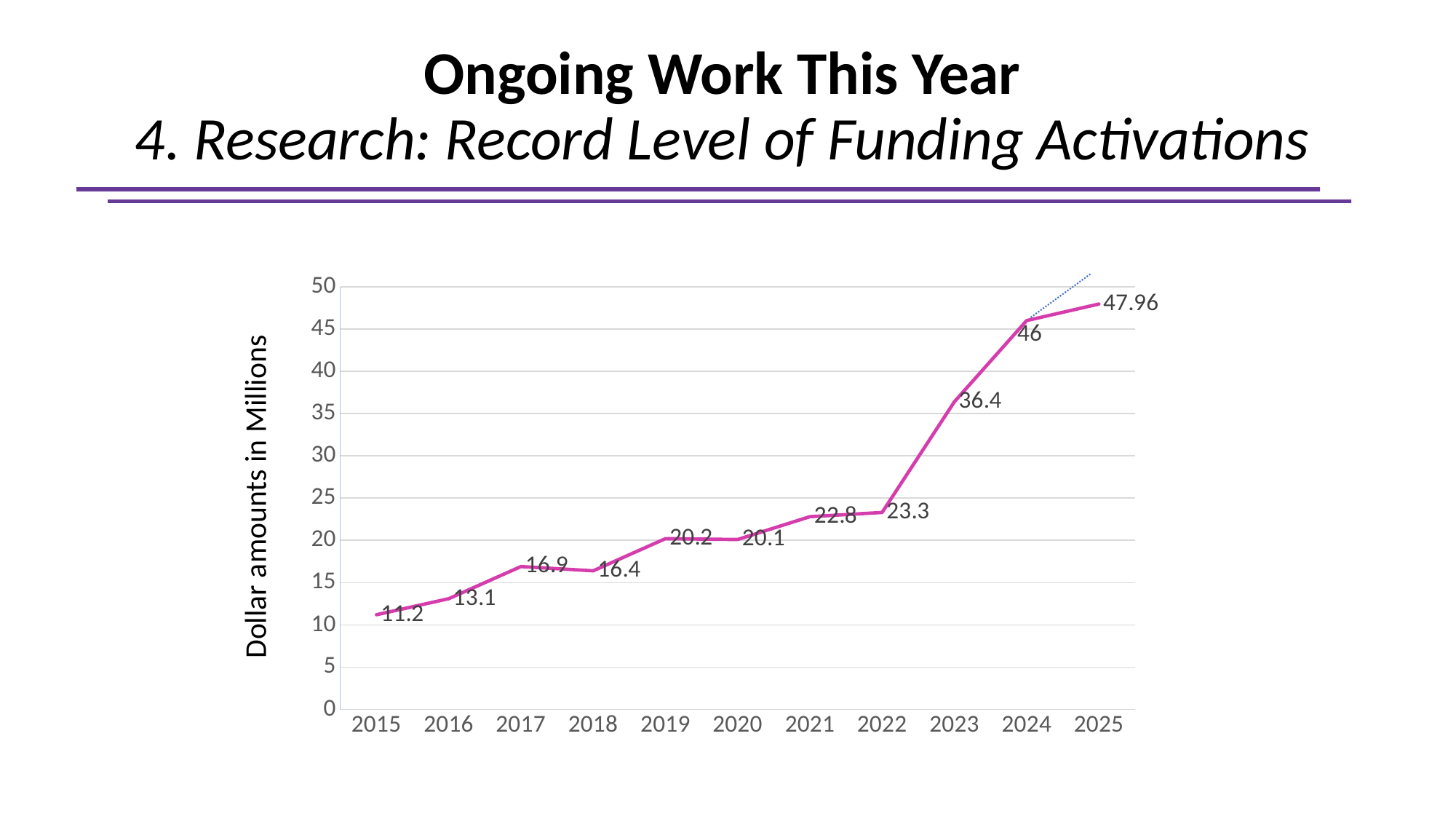
What is the value for 2025? 47.96 How many years are plotted on the x axis? 11 Is the value for 2022 greater or less than 25? less What kind of chart is shown? line chart Which year has the lowest value? 2015 What is the value for 2018? 16.4 Which is larger, the value for 2017 or the value for 2018? 2017 Which year has the highest value? 2025 What is the label on the vertical axis? Dollar amounts in Millions Do the values generally rise or fall from 2015 to 2025? rise What is the difference between the values for 2024 and 2023? 9.6 What is the value for 2023? 36.4